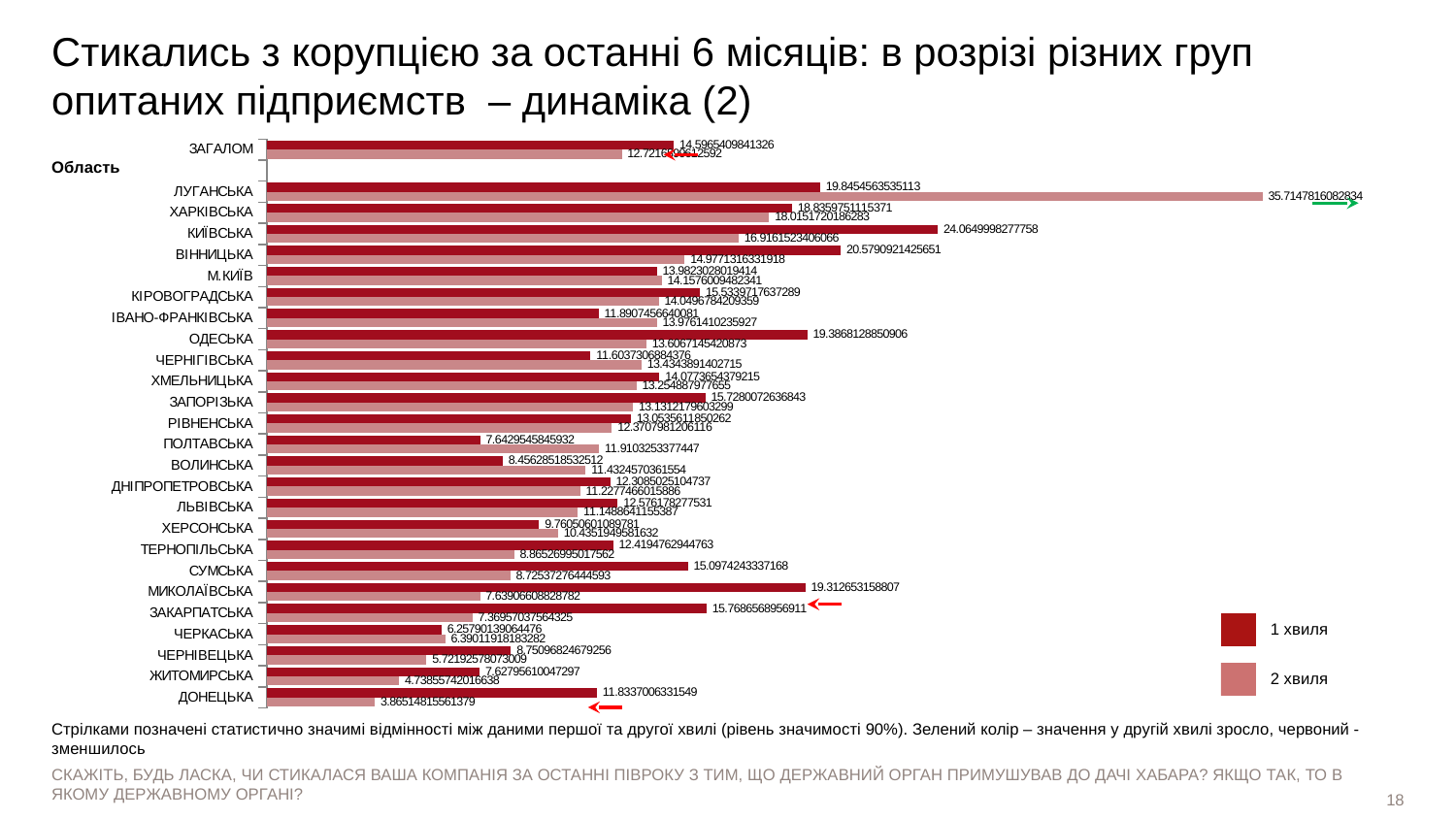
Which legend entry is shown in the darker red colour? 1 хвиля How many series does the legend list? 2 What is the value for ДОНЕЦЬКА in the 2 хвиля series? 3.86514815561379 Which region has the lowest value in the 2 хвиля series? ДОНЕЦЬКА What kind of chart is shown on the slide? bar chart For МИКОЛАЇВСЬКА, which series has the larger value, 1 хвиля or 2 хвиля? 1 хвиля For ПОЛТАВСЬКА, which series has the larger value, 1 хвиля or 2 хвиля? 2 хвиля Which region has the highest value in the 2 хвиля series? ЛУГАНСЬКА Which region has the highest value in the 1 хвиля series? КИЇВСЬКА What is the value for КИЇВСЬКА in the 1 хвиля series? 24.0649998277758 What is the value for ЛУГАНСЬКА in the 2 хвиля series? 35.7147816082834 What is the difference between the 2 хвиля and 1 хвиля values for ЛУГАНСЬКА? 15.8693252547721